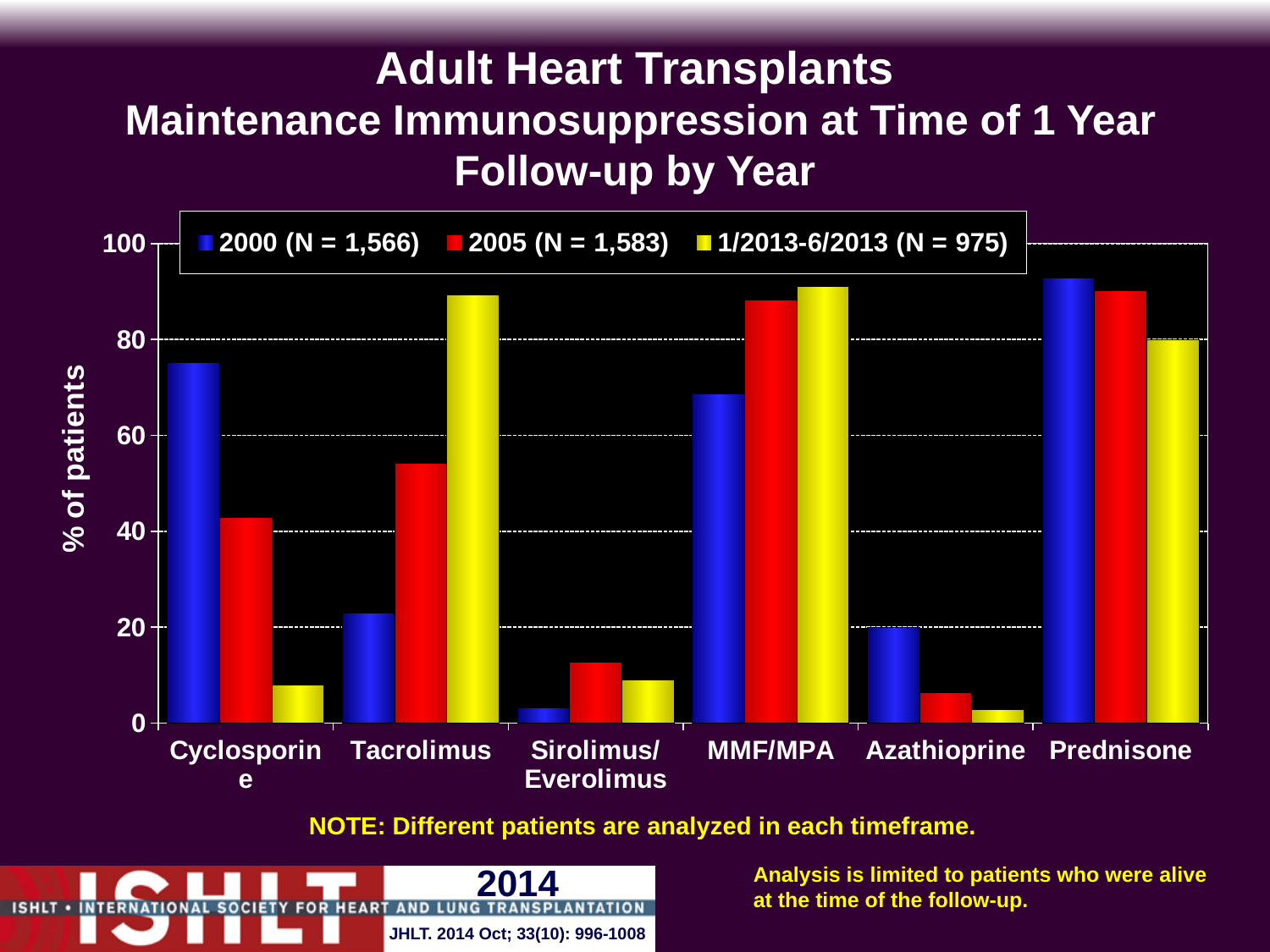
Which drug has the lowest value for the 2000 series? Sirolimus/Everolimus According to the legend, what is N for the 2005 series? 1,583 How many drug categories are shown on the x axis? 6 Is the value for Azathioprine in 2005 greater or less than 20? less Is the value for Cyclosporine in 2000 greater or less than 60? greater What kind of chart is shown on the slide? Bar chart Which is larger in 2005: MMF/MPA or Tacrolimus? MMF/MPA Which drug has the highest value for the 2000 series? Prednisone How many series does the legend list? 3 Does the value for Tacrolimus rise or fall from 2000 to 2005 to 1/2013-6/2013? rise Is the value for Tacrolimus in 1/2013-6/2013 greater or less than 80? greater Which is larger for Cyclosporine: the 2000 value or the 1/2013-6/2013 value? 2000